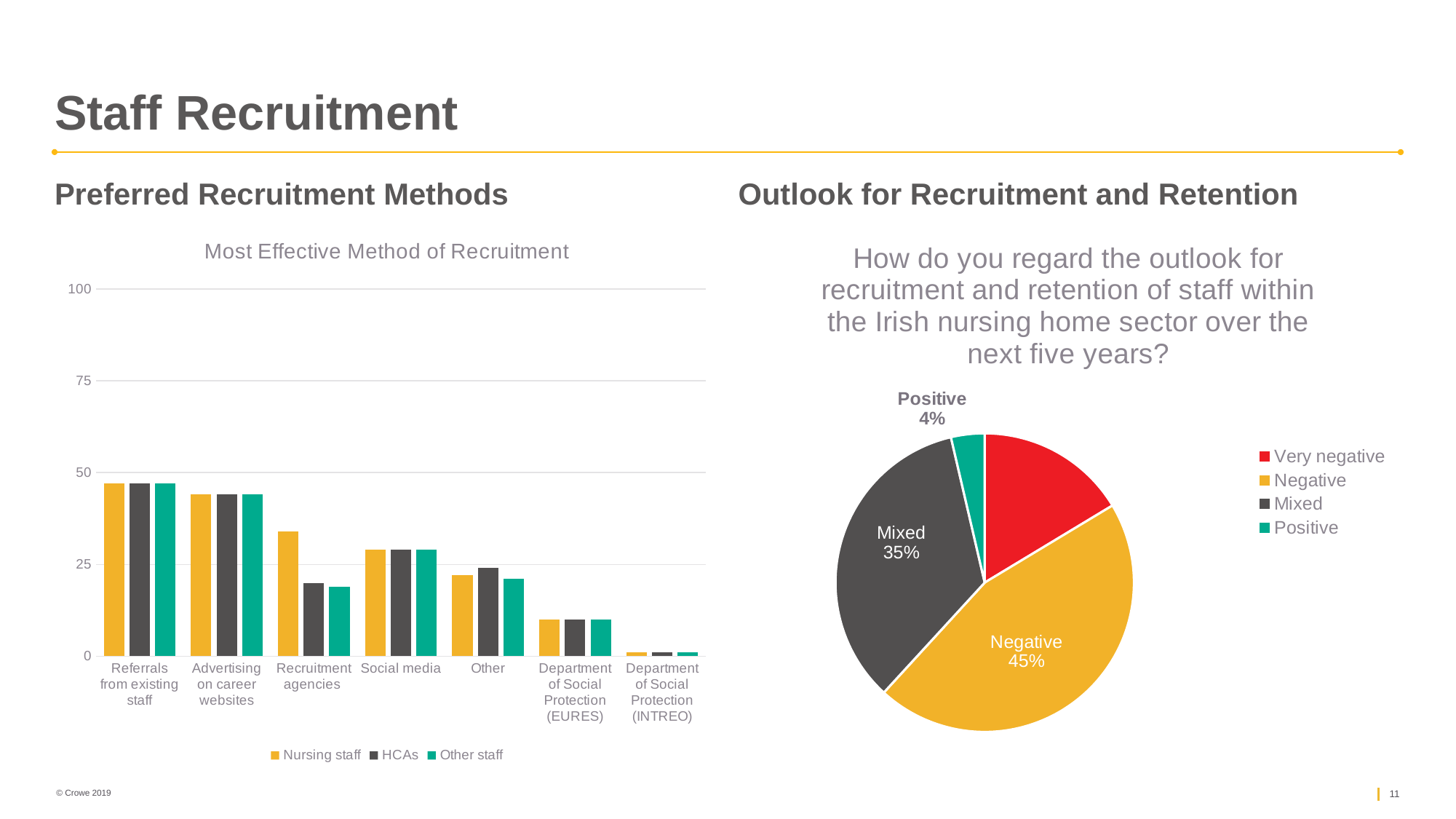
In the pie chart on the right, how many percentage points larger is the Negative slice than the Mixed slice? 10 In the 'Most Effective Method of Recruitment' chart, for 'Recruitment agencies', which is larger: the Nursing staff value or the HCAs value? Nursing staff In the pie chart on the right, which outlook category has the smallest slice? Positive In the 'Most Effective Method of Recruitment' chart, which recruitment method has the lowest values across all three series? Department of Social Protection (INTREO) How many recruitment method categories are shown on the x axis of the 'Most Effective Method of Recruitment' chart? 7 How many series does the legend of the 'Most Effective Method of Recruitment' chart list? 3 What kind of chart is 'Most Effective Method of Recruitment'? Bar chart In the pie chart on the right, what share of respondents regard the outlook as Negative? 45% In the pie chart on the right, what percentage is labelled Mixed? 35% In the 'Most Effective Method of Recruitment' chart, is the Nursing staff value for 'Referrals from existing staff' greater or less than 25? greater In the pie chart on the right, which outlook category has the largest slice? Negative How many entries does the legend of the pie chart on the right list? 4